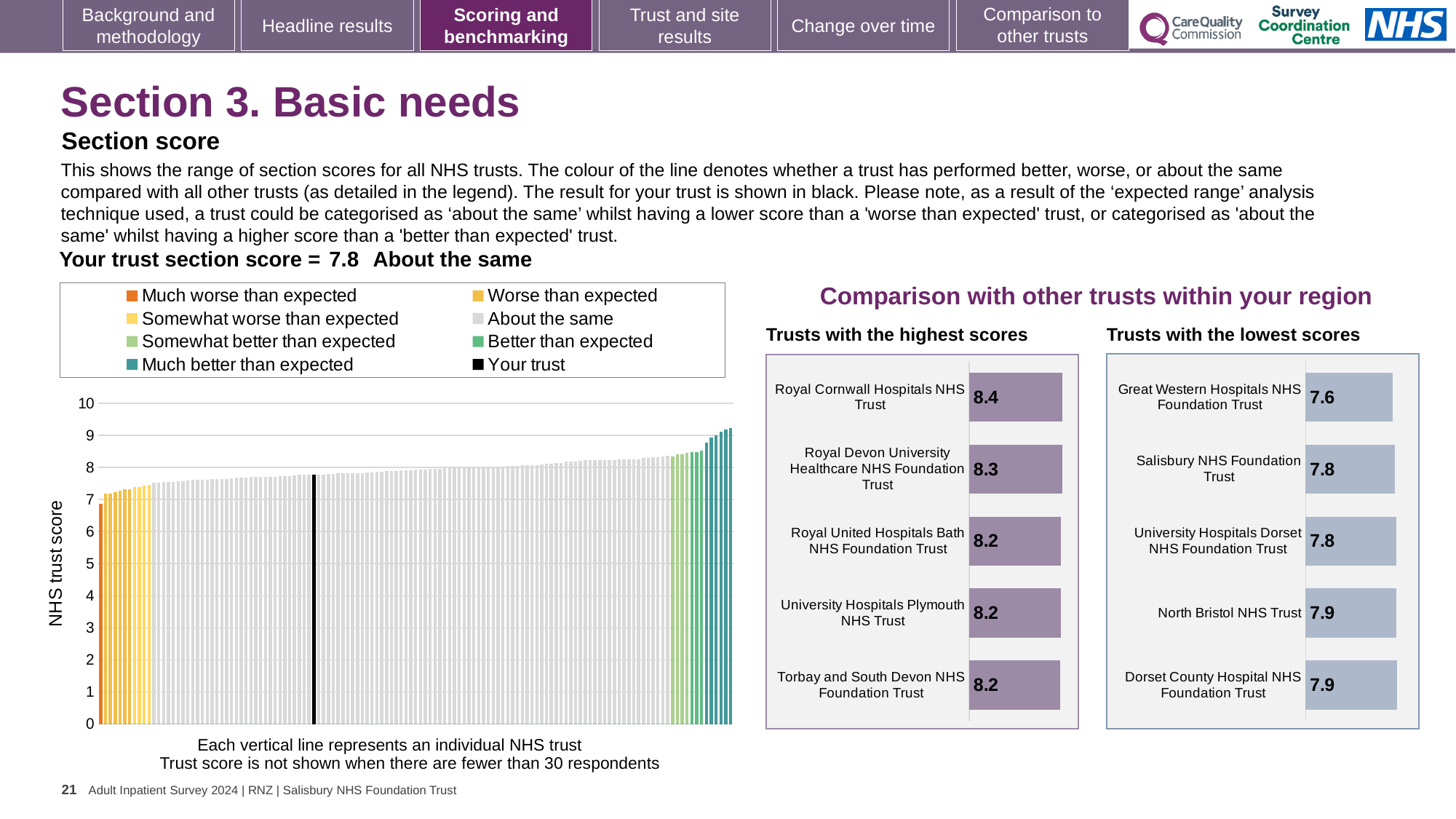
How many entries does the legend of the main NHS trust score chart list? 8 On the main NHS trust score chart, do the values rise or fall from left to right? Rise On the 'Trusts with the lowest scores' chart, which has the larger score: Salisbury NHS Foundation Trust or Great Western Hospitals NHS Foundation Trust? Salisbury NHS Foundation Trust On the main NHS trust score chart, is the value of the tallest bar greater or less than 9? greater On the 'Trusts with the highest scores' chart, what is the score for Royal Cornwall Hospitals NHS Trust? 8.4 On the 'Trusts with the lowest scores' chart, what is the score for Great Western Hospitals NHS Foundation Trust? 7.6 On the 'Trusts with the highest scores' chart, which trust has the highest score? Royal Cornwall Hospitals NHS Trust On the 'Trusts with the lowest scores' chart, what is the difference between the scores of North Bristol NHS Trust and Great Western Hospitals NHS Foundation Trust? 0.3 On the 'Trusts with the highest scores' chart, what is the difference between the scores of Royal Cornwall Hospitals NHS Trust and Torbay and South Devon NHS Foundation Trust? 0.2 On the 'Trusts with the lowest scores' chart, which trust has the lowest score? Great Western Hospitals NHS Foundation Trust What kind of chart is the main chart showing NHS trust scores on the left of the slide? Bar chart How many trusts are shown on the 'Trusts with the highest scores' chart? 5